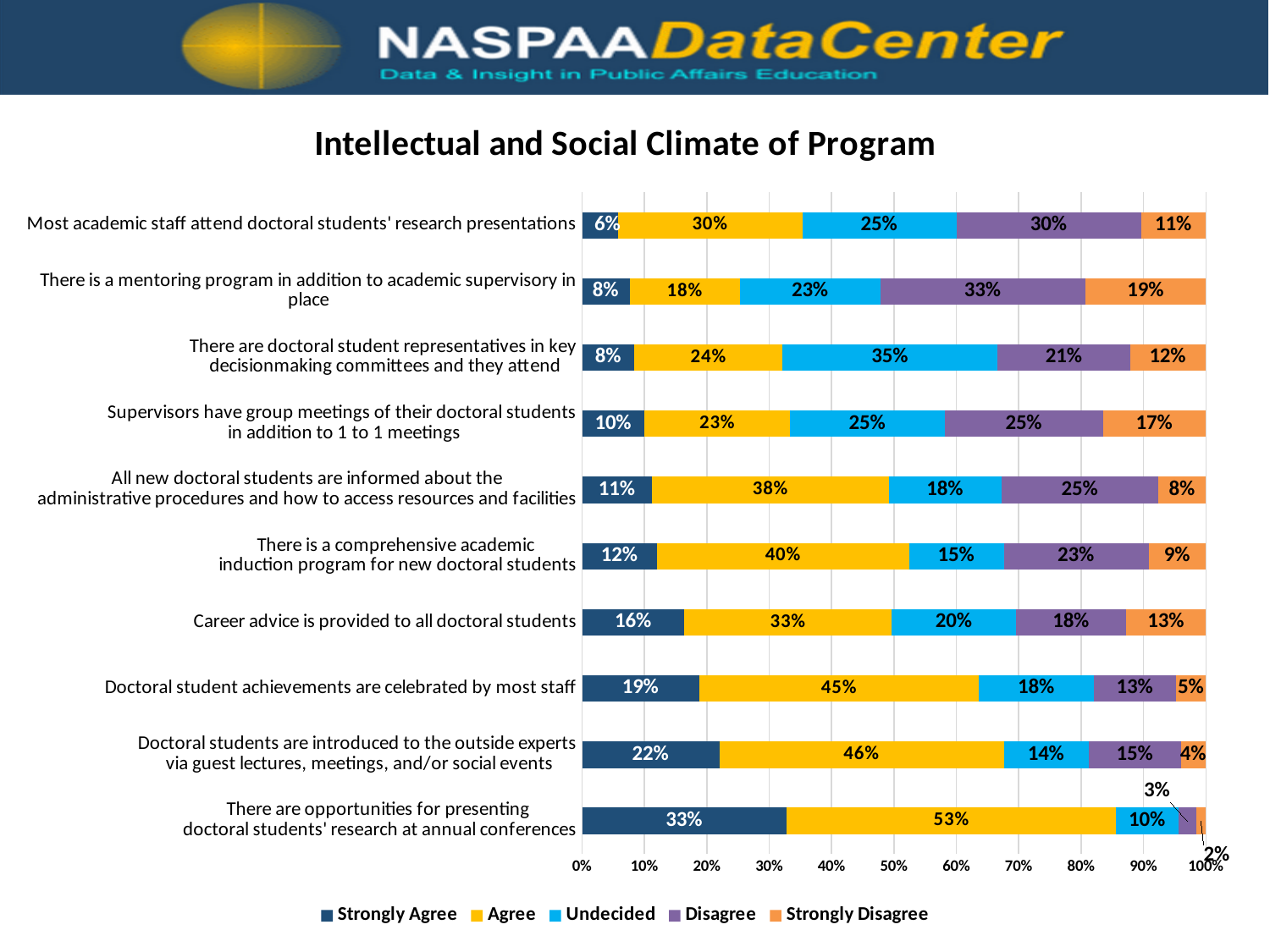
What is the difference between the 'Agree' values for 'Doctoral student achievements are celebrated by most staff' and 'Career advice is provided to all doctoral students'? 12% What percentage of respondents 'Strongly Agree' that there are opportunities for presenting doctoral students' research at annual conferences? 33% What is the 'Strongly Disagree' value for 'Doctoral students are introduced to the outside experts via guest lectures, meetings, and/or social events'? 4% How many series does the legend list? 5 Which statement has the lowest 'Strongly Agree' percentage? Most academic staff attend doctoral students' research presentations Which is larger: the 'Strongly Disagree' value for 'There is a mentoring program in addition to academic supervisory in place' or for 'Supervisors have group meetings of their doctoral students in addition to 1 to 1 meetings'? There is a mentoring program in addition to academic supervisory in place Which colour represents the 'Agree' series in the chart? Yellow What is the 'Disagree' value for 'There is a mentoring program in addition to academic supervisory in place'? 33% Which statement has the highest 'Strongly Agree' percentage? There are opportunities for presenting doctoral students' research at annual conferences How many statements (categories) are plotted in the chart? 10 What is the 'Undecided' value for 'There are doctoral student representatives in key decisionmaking committees and they attend'? 35% What kind of chart is shown on the slide? Stacked bar chart